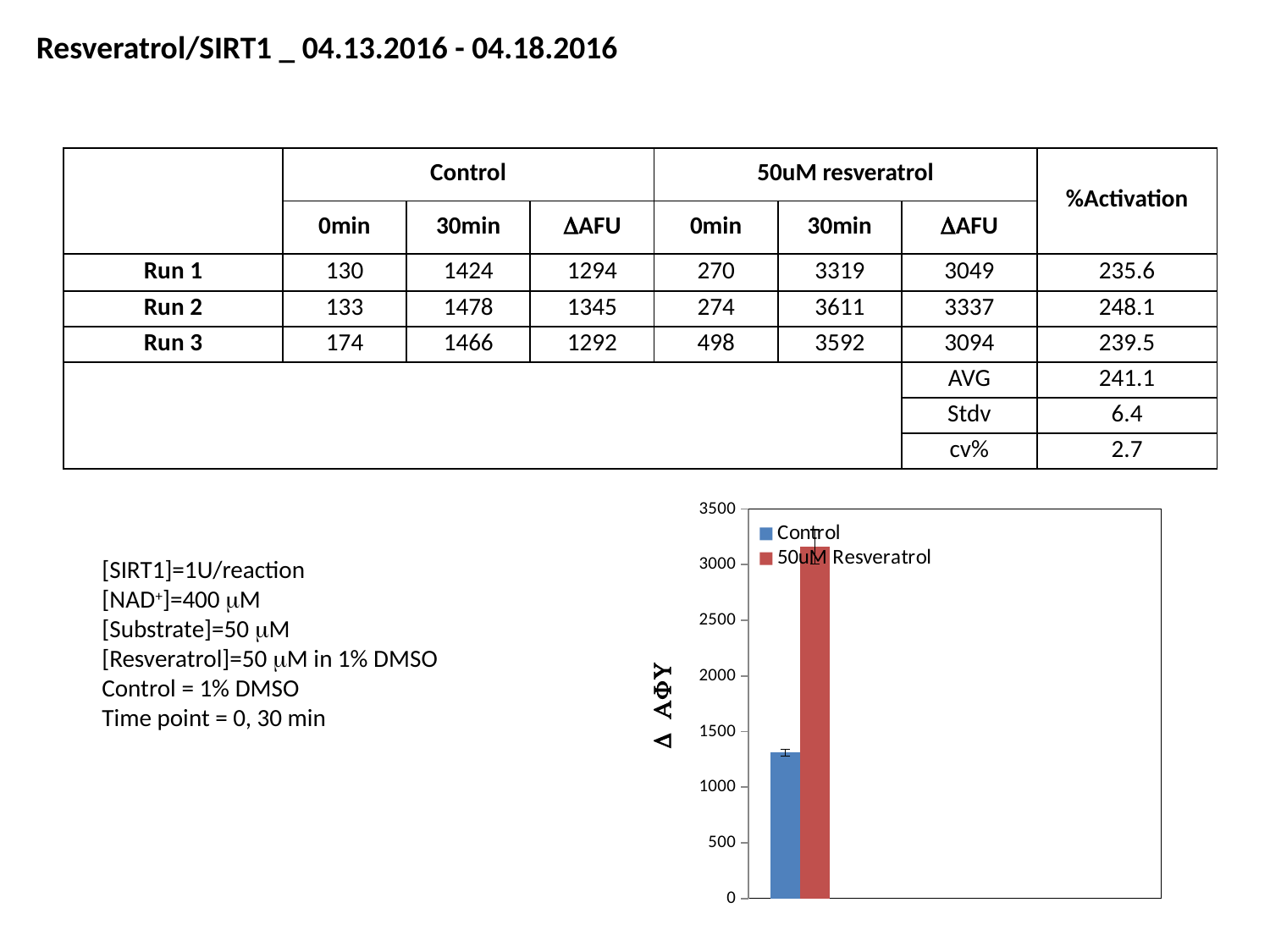
What kind of chart is shown on the slide? bar chart How many bars are plotted in the chart? 2 Is the value for Control greater or less than 1000? greater Is the value for Control greater or less than 1500? less Which series has the taller bar in the chart, Control or 50uM Resveratrol? 50uM Resveratrol What colour is the Control series in the chart? blue Is the value for 50uM Resveratrol greater or less than 3000? greater Which series has the shorter bar in the chart? Control How many series does the chart legend list? 2 Is the bar for Control taller or shorter than the bar for 50uM Resveratrol? shorter What is the highest tick value shown on the chart's vertical axis? 3500